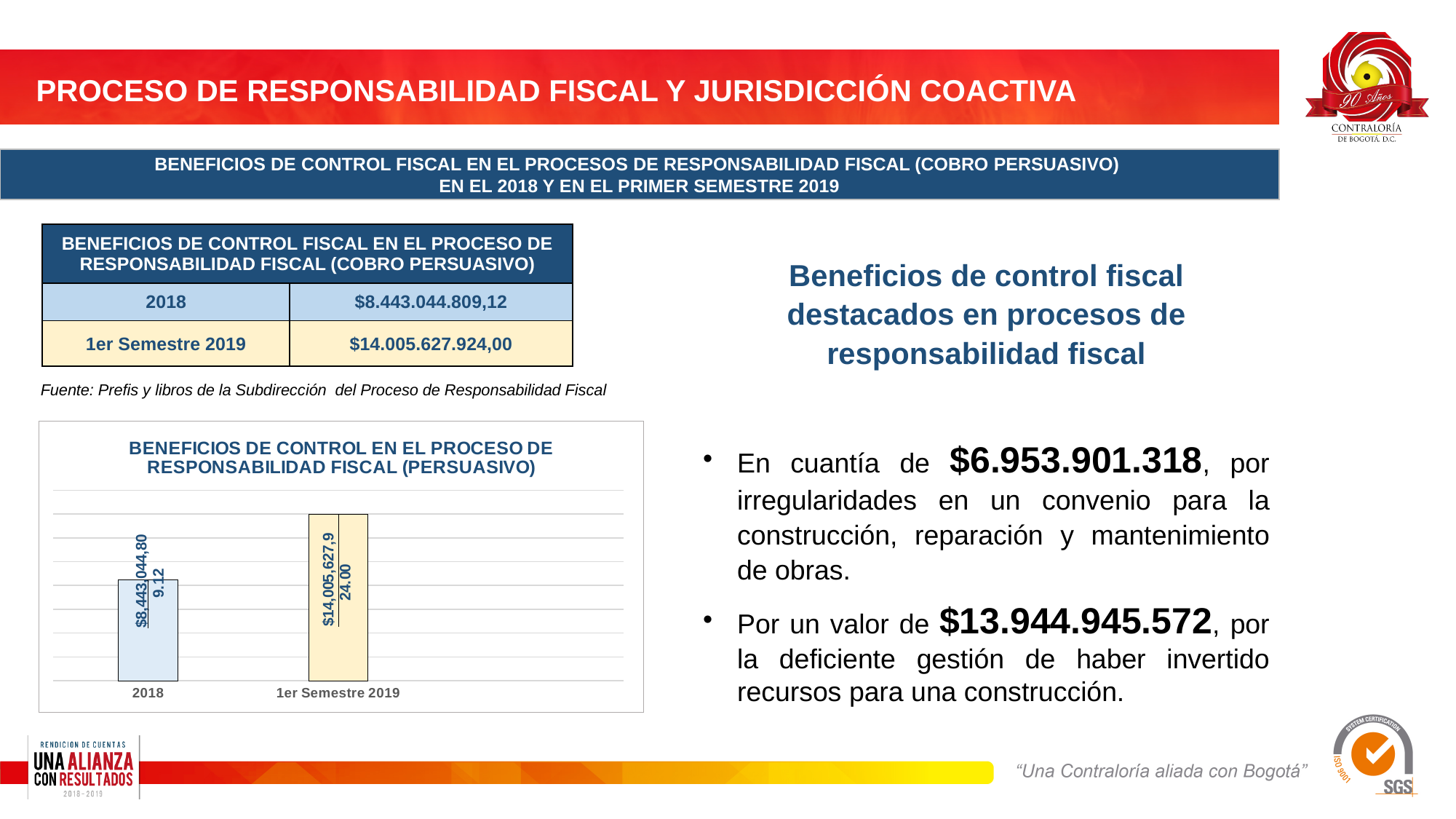
What is the difference between the value for 1er Semestre 2019 and the value for 2018 in the chart? $5,562,583,114.88 Do the values in the chart rise or fall from 2018 to 1er Semestre 2019? rise How many categories are plotted in the chart? 2 What is the value shown for 1er Semestre 2019 in the chart? $14,005,627,924.00 What is the title of the chart? BENEFICIOS DE CONTROL EN EL PROCESO DE RESPONSABILIDAD FISCAL (PERSUASIVO) What kind of chart is shown on the slide? bar chart Which category has the highest value in the chart? 1er Semestre 2019 Which is larger in the chart, the value for 2018 or the value for 1er Semestre 2019? 1er Semestre 2019 What is the value shown for 2018 in the chart? $8,443,044,809.12 What colour is the bar for 1er Semestre 2019 in the chart? light yellow Which category has the lowest value in the chart? 2018